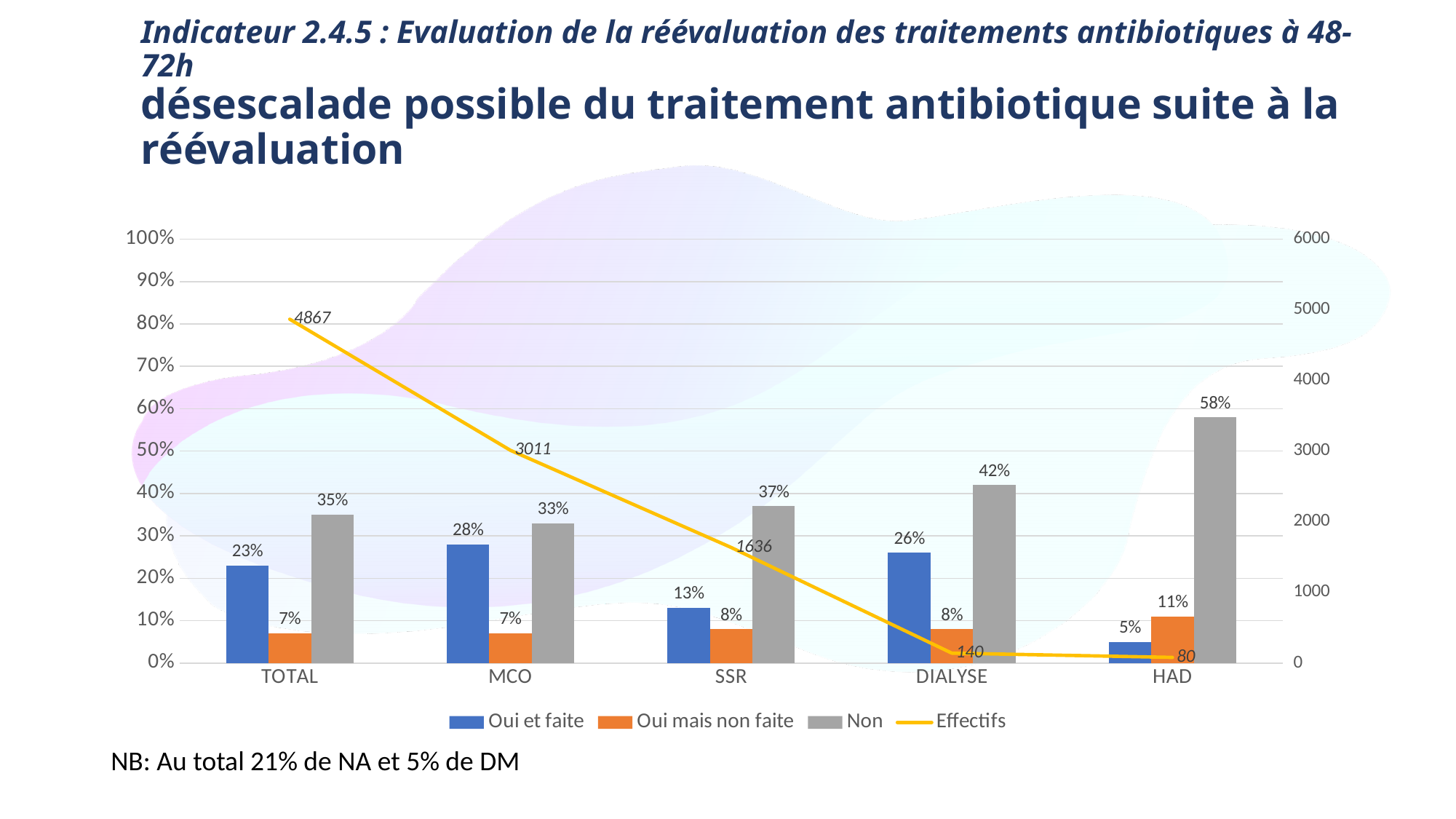
What is the value of "Oui mais non faite" for DIALYSE? 8% What is the value of "Non" for HAD? 58% How many categories are shown on the x axis? 5 Which category has the highest "Non" value? HAD Does the Effectifs line rise or fall from TOTAL to HAD? fall What is the Effectifs value for SSR? 1636 Which category has the lowest "Oui et faite" value? HAD Which category has the highest Effectifs value? TOTAL What is the difference between the "Non" value for HAD and the "Non" value for TOTAL? 23% How many series does the legend list? 4 What is the value of "Oui et faite" for MCO? 28% Which is larger: "Oui et faite" for SSR or "Oui et faite" for DIALYSE? DIALYSE